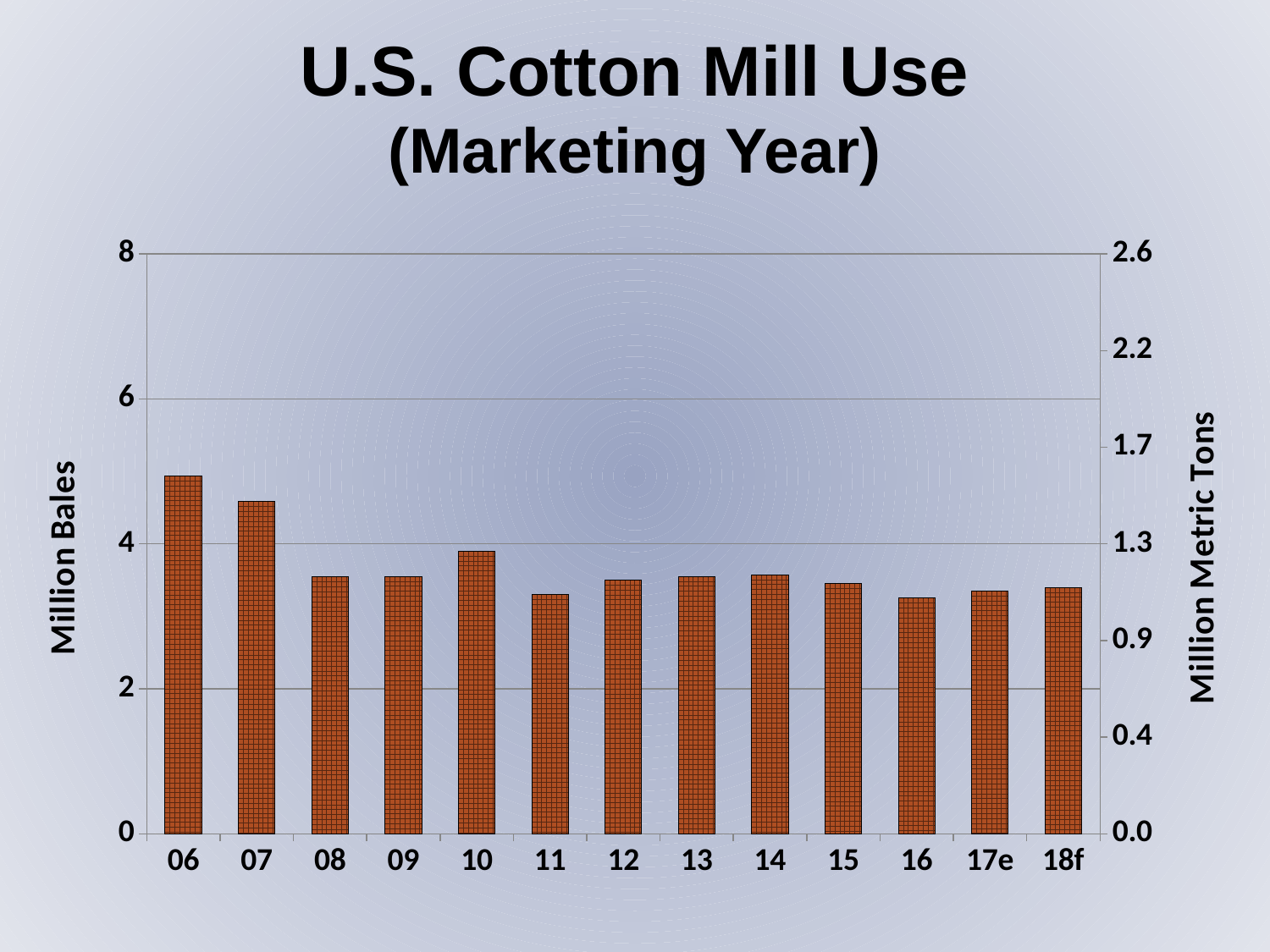
Overall, do the values rise or fall from 06 to 18f? fall How many marketing years are plotted on the chart? 13 What is the label of the right vertical axis? Million Metric Tons Which marketing year has the highest cotton mill use? 06 Is the value for 16 greater or less than 4 million bales? less Is the value for 08 greater or less than 4 million bales? less Is the value for 18f greater or less than 2 million bales? greater Which is larger, the value for 06 or the value for 07? 06 What kind of chart is shown on the slide? bar chart Which is larger, the value for 10 or the value for 11? 10 What is the label of the left vertical axis? Million Bales